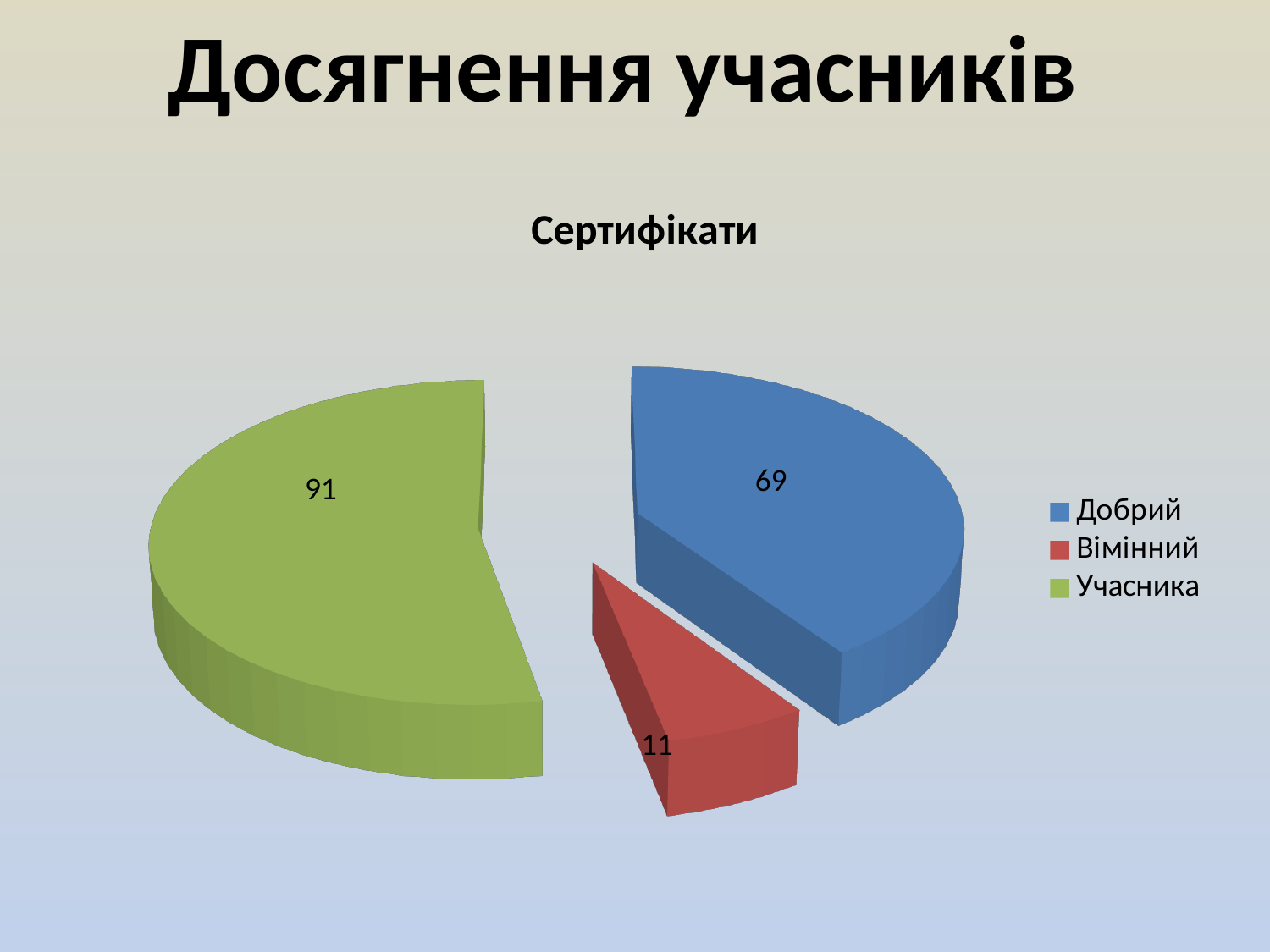
What is the difference between the values for Учасника and Добрий in the Сертифікати chart? 22 What is the value for Вімінний in the Сертифікати pie chart? 11 What kind of chart is shown on the slide? Pie chart What colour is the Учасника slice in the Сертифікати pie chart? Green Which category has the smallest slice in the Сертифікати pie chart? Вімінний What is the total of all slices in the Сертифікати pie chart? 171 Which category has the largest slice in the Сертифікати pie chart? Учасника What is the value for Учасника in the Сертифікати pie chart? 91 What is the value for Добрий in the Сертифікати pie chart? 69 Which is larger in the Сертифікати chart, Добрий or Вімінний? Добрий What is the difference between the values for Добрий and Вімінний in the Сертифікати chart? 58 How many categories are shown in the Сертифікати pie chart? 3